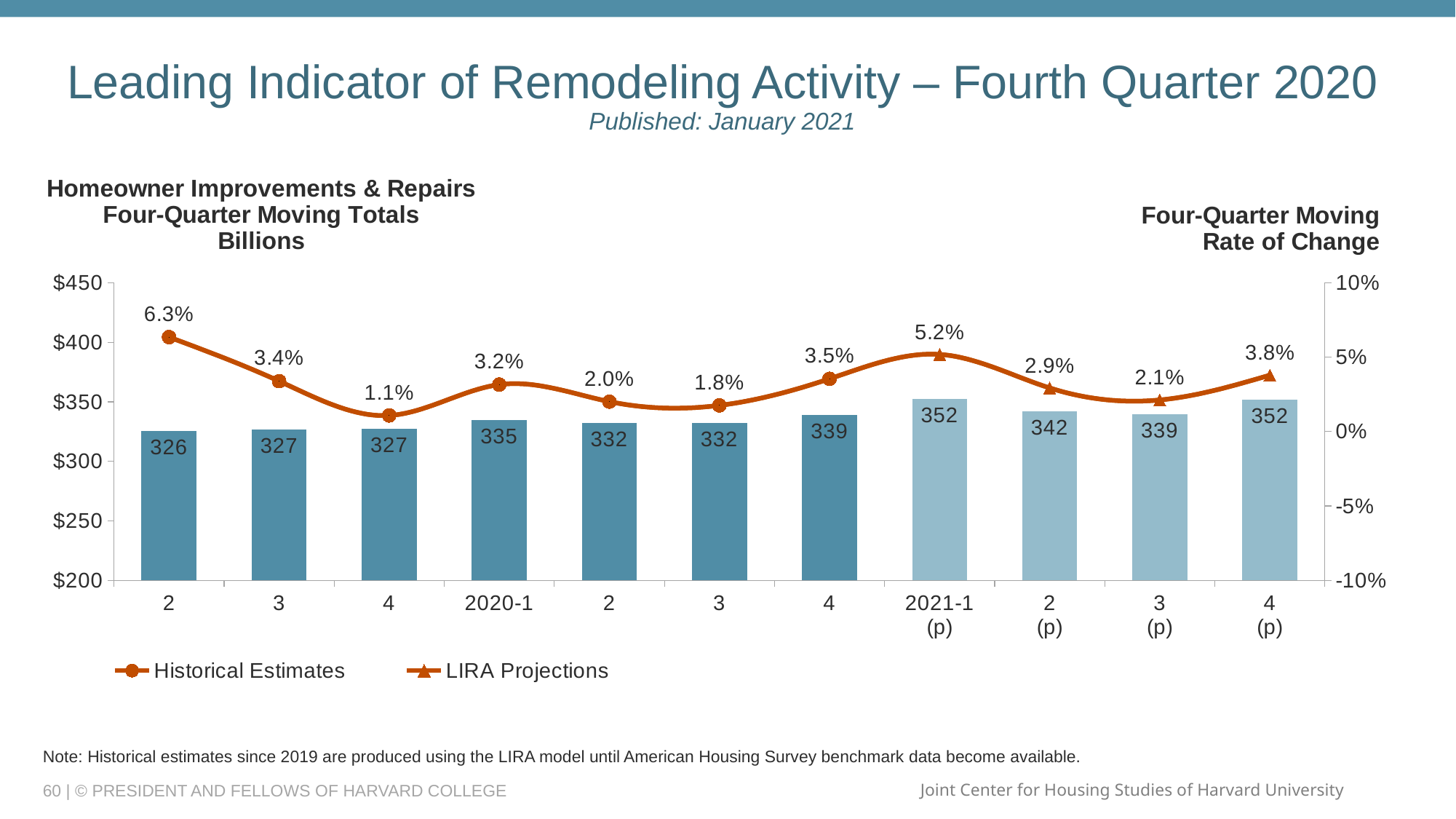
Which has the larger four-quarter moving total: 2020-1 or the following quarter 2 (332)? 2020-1 (335) What is the lowest four-quarter moving total (in billions) shown by the bars? 326 What kind of chart is shown on the slide? A combination bar and line chart What is the lowest four-quarter moving rate of change shown on the line? 1.1% What is the four-quarter moving total (in billions) for 4 (p), the last bar on the chart? 352 What is the four-quarter moving total (in billions) for 2020-1? 335 Which quarter has the highest four-quarter moving rate of change? 2 (the first quarter shown), at 6.3% How many bars (quarters) are plotted on the chart? 11 How many series does the legend list? 2 How much higher is the four-quarter moving total for 2021-1 (p) than for the preceding quarter 4 (339)? 13 What is the four-quarter moving rate of change for 2021-1 (p)? 5.2% Does the rate of change line rise or fall from the first quarter shown (6.3%) to the third quarter shown (1.1%)? Fall